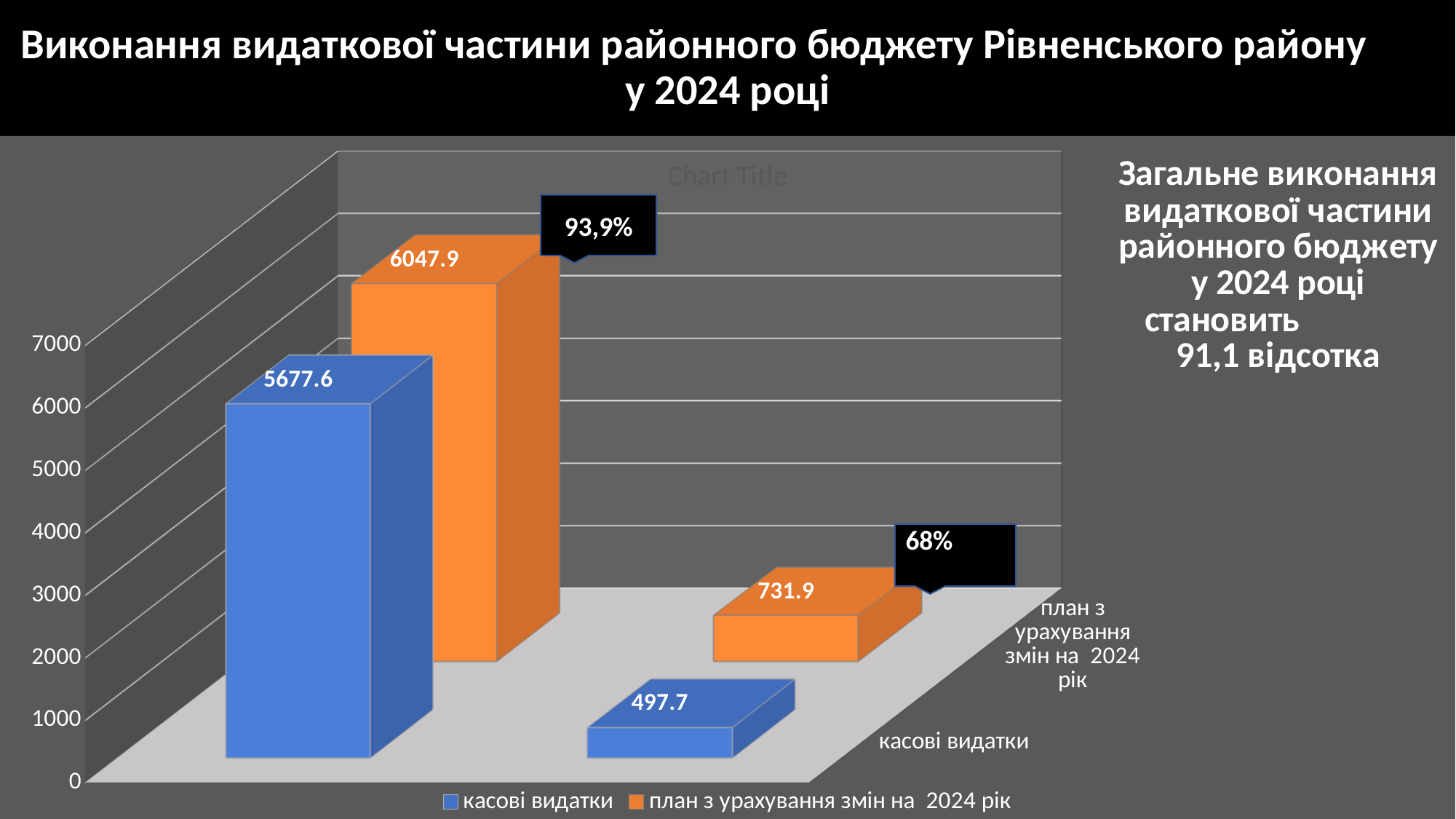
What is the value of the smaller blue (касові видатки) bar on the chart? 497.7 What kind of chart is shown on the slide? bar chart In the left group of bars, which series has the larger value: касові видатки or план з урахування змін на 2024 рік? план з урахування змін на 2024 рік What is the lowest value plotted on the chart? 497.7 What is the value of the smaller orange (план з урахування змін на 2024 рік) bar on the chart? 731.9 How many series does the legend list? 2 What is the difference between the tallest orange bar (6047.9) and the tallest blue bar (5677.6)? 370.3 What percentage is shown in the callout above the tallest orange bar? 93,9% What is the value of the tallest orange (план з урахування змін на 2024 рік) bar on the chart? 6047.9 What is the value of the tallest blue (касові видатки) bar on the chart? 5677.6 What is the highest value plotted on the chart? 6047.9 What is the difference between the smaller orange bar (731.9) and the smaller blue bar (497.7)? 234.2